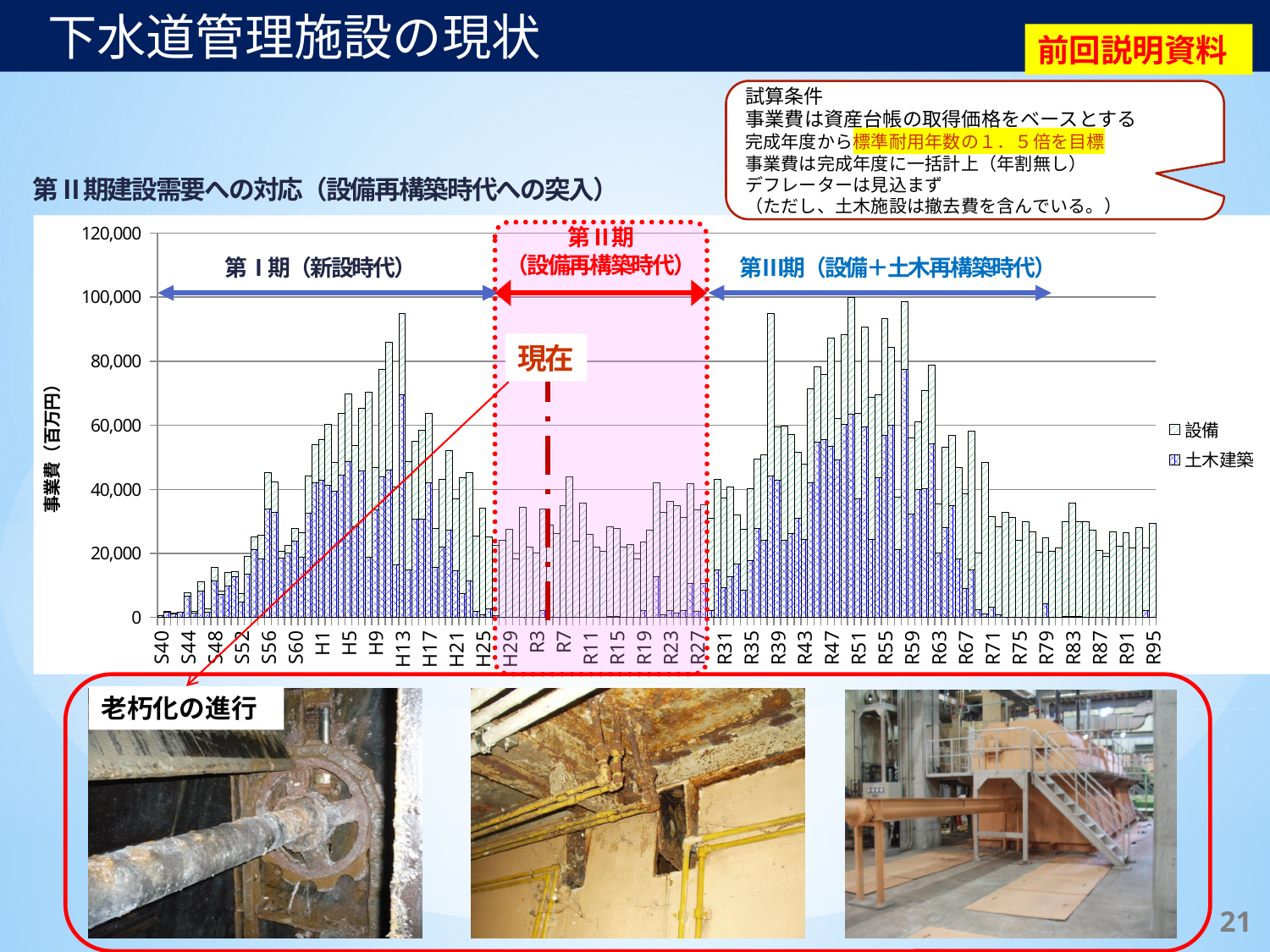
Which has the larger value, S40 or H13? H13 Is the value for S40 greater or less than 20,000? less How many series does the chart's legend list? 2 What are the two series named in the chart's legend? 設備, 土木建築 Do the values generally rise or fall along the x axis from S40 to H13? rise Is the value for R95 greater or less than 40,000? less Is the value for R51 greater or less than 80,000? less What is the label of the chart's vertical axis? 事業費（百万円） What kind of chart is shown on the slide? bar chart Which has the larger value, R51 or R95? R51